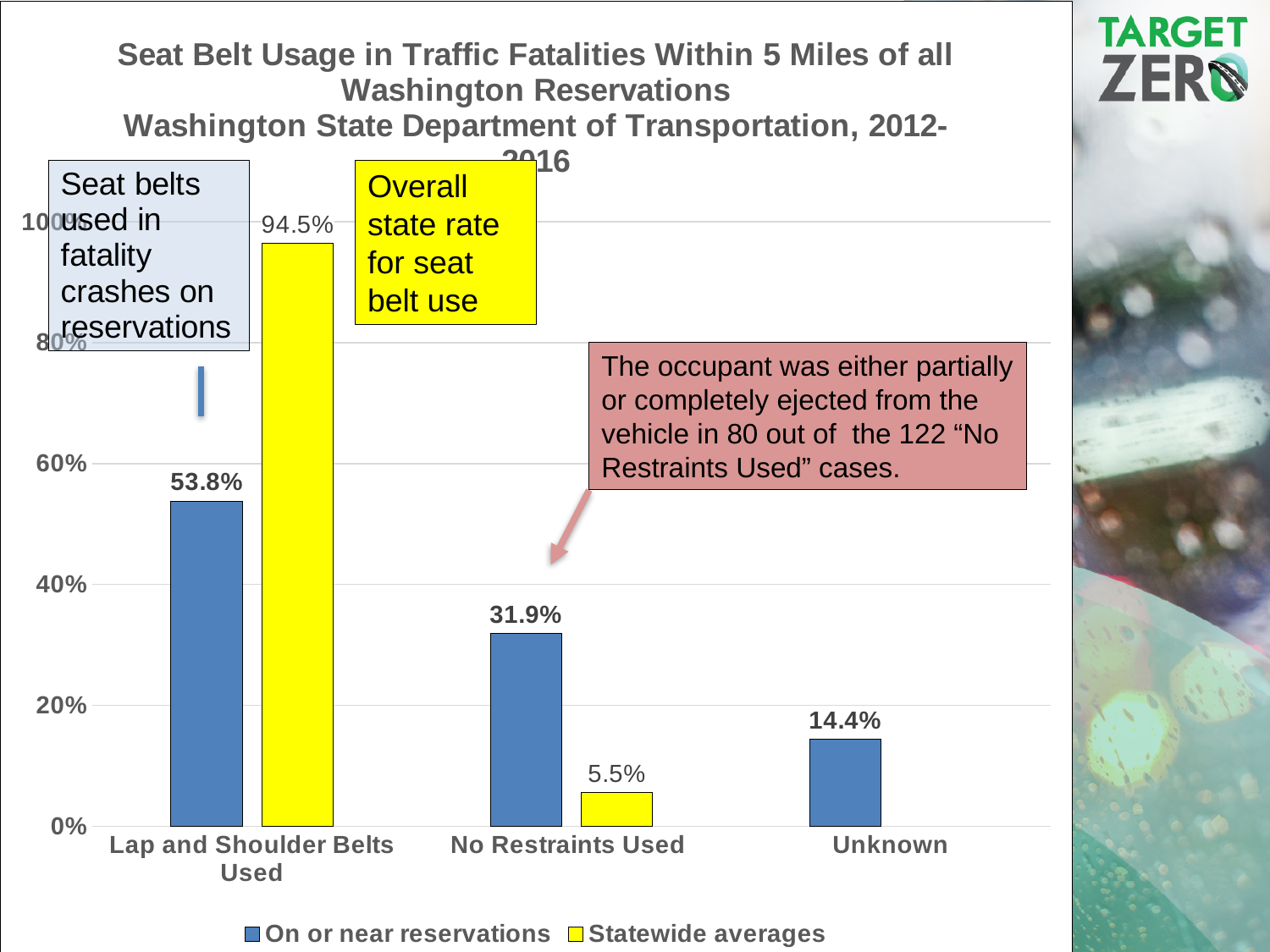
What is the difference between the Statewide averages and On or near reservations values for Lap and Shoulder Belts Used? 40.7% How many categories are shown on the x axis? 3 What is the value for On or near reservations in the Lap and Shoulder Belts Used category? 53.8% What is the value for On or near reservations in the No Restraints Used category? 31.9% What is the Statewide averages value for Lap and Shoulder Belts Used? 94.5% What is the Statewide averages value for No Restraints Used? 5.5% How many series does the legend list? 2 Which category has the lowest value for the On or near reservations series? Unknown For No Restraints Used, which is larger: On or near reservations or Statewide averages? On or near reservations What kind of chart is shown on the slide? Bar chart What is the value for On or near reservations in the Unknown category? 14.4% Which category has the highest value for the On or near reservations series? Lap and Shoulder Belts Used